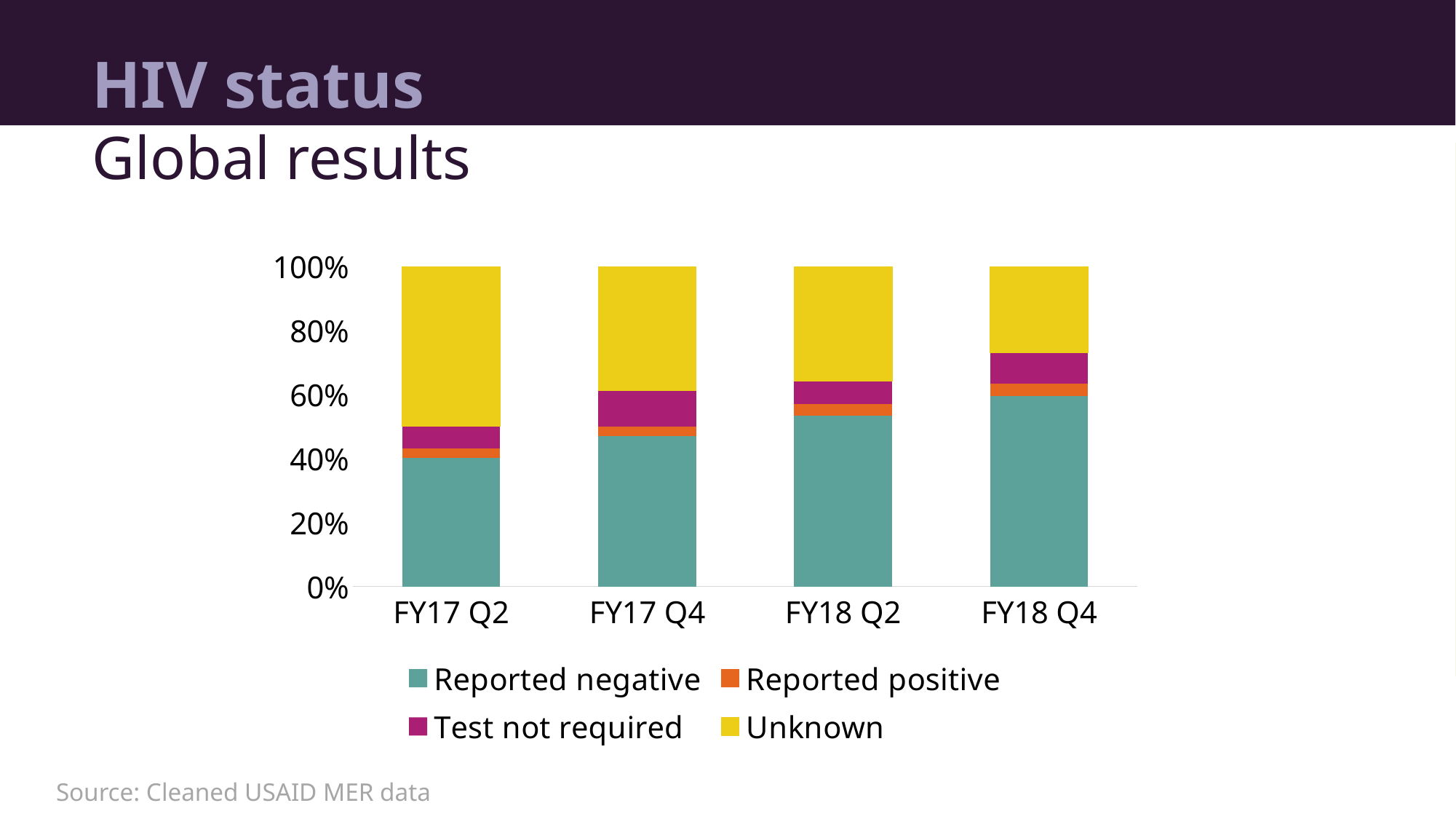
What kind of chart is shown on the slide? Stacked bar chart Does the Reported negative share rise or fall from FY17 Q2 to FY18 Q4? Rise Which quarter has the larger Unknown share, FY17 Q2 or FY18 Q4? FY17 Q2 How many series does the chart's legend list? 4 In which quarter is the Reported negative share the highest? FY18 Q4 Does the Unknown share rise or fall from FY17 Q2 to FY18 Q4? Fall What is the subtitle of the chart on the slide? Global results How many quarters are shown on the x axis of the chart? 4 Is the Reported negative share for FY17 Q4 greater or less than 60%? less In which quarter is the Reported negative share the lowest? FY17 Q2 Which series is shown in yellow in the chart? Unknown Is the Reported negative share for FY18 Q2 greater or less than 40%? greater